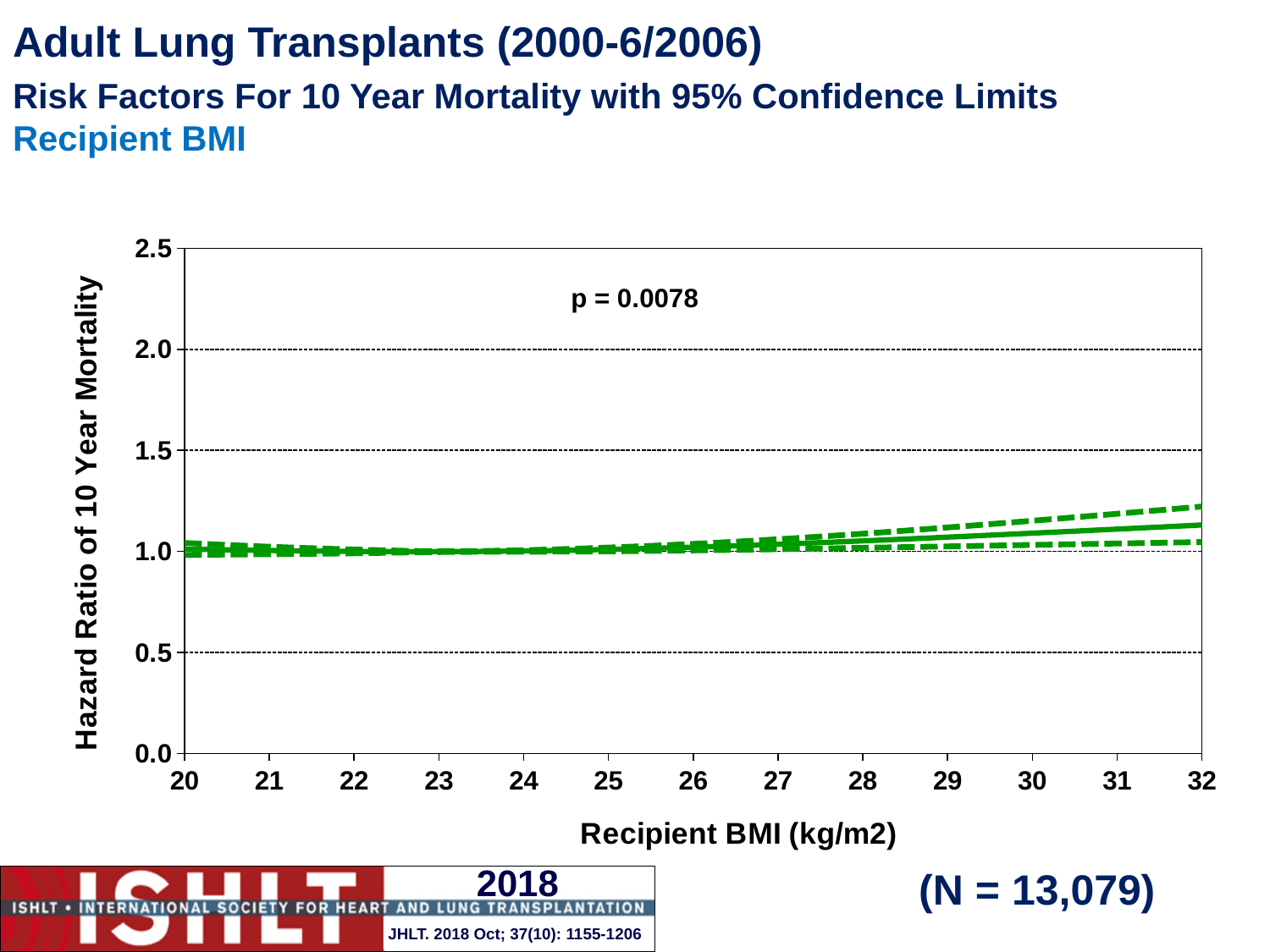
Is the hazard ratio at a recipient BMI of 24 greater or less than 1.5? less What kind of chart is shown on the slide? line chart Is the hazard ratio at a recipient BMI of 32 larger or smaller than at a recipient BMI of 24? larger Does the hazard ratio rise or fall as recipient BMI increases from 27 to 32? rise What p-value is printed on the chart? p = 0.0078 How many recipient BMI tick values are labelled on the x axis? 13 What is the sample size (N) shown on the slide? N = 13,079 Is the hazard ratio at a recipient BMI of 20 greater or less than 0.5? greater Is the hazard ratio for a recipient BMI of 32 greater or less than 1.5? less At which recipient BMI value on the x axis is the hazard ratio highest? 32